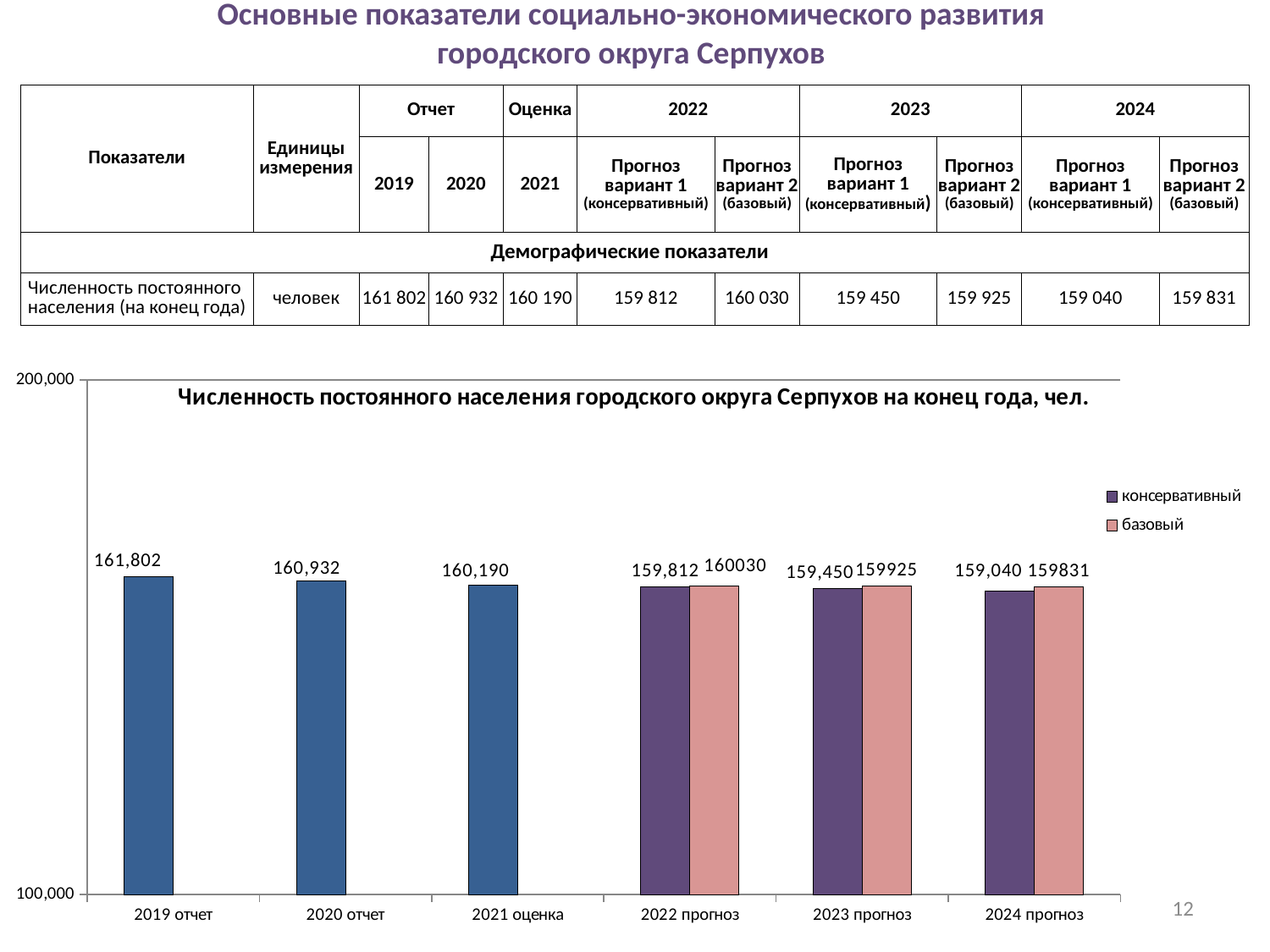
What is the difference between the базовый and консервативный values for 2023 прогноз? 475 Which bar has the lowest value? консервативный for 2024 прогноз What is the value for 2021 оценка? 160,190 How many series does the legend list? 2 What is the difference between the 2019 отчет value and the 2020 отчет value? 870 What is the value for 2019 отчет? 161,802 What is the консервативный value for 2022 прогноз? 159,812 How many categories are shown on the x axis? 6 What type of chart is shown on the slide? bar chart What is the базовый value for 2024 прогноз? 159831 Which category has the highest value? 2019 отчет What is the title of the chart? Численность постоянного населения городского округа Серпухов на конец года, чел.